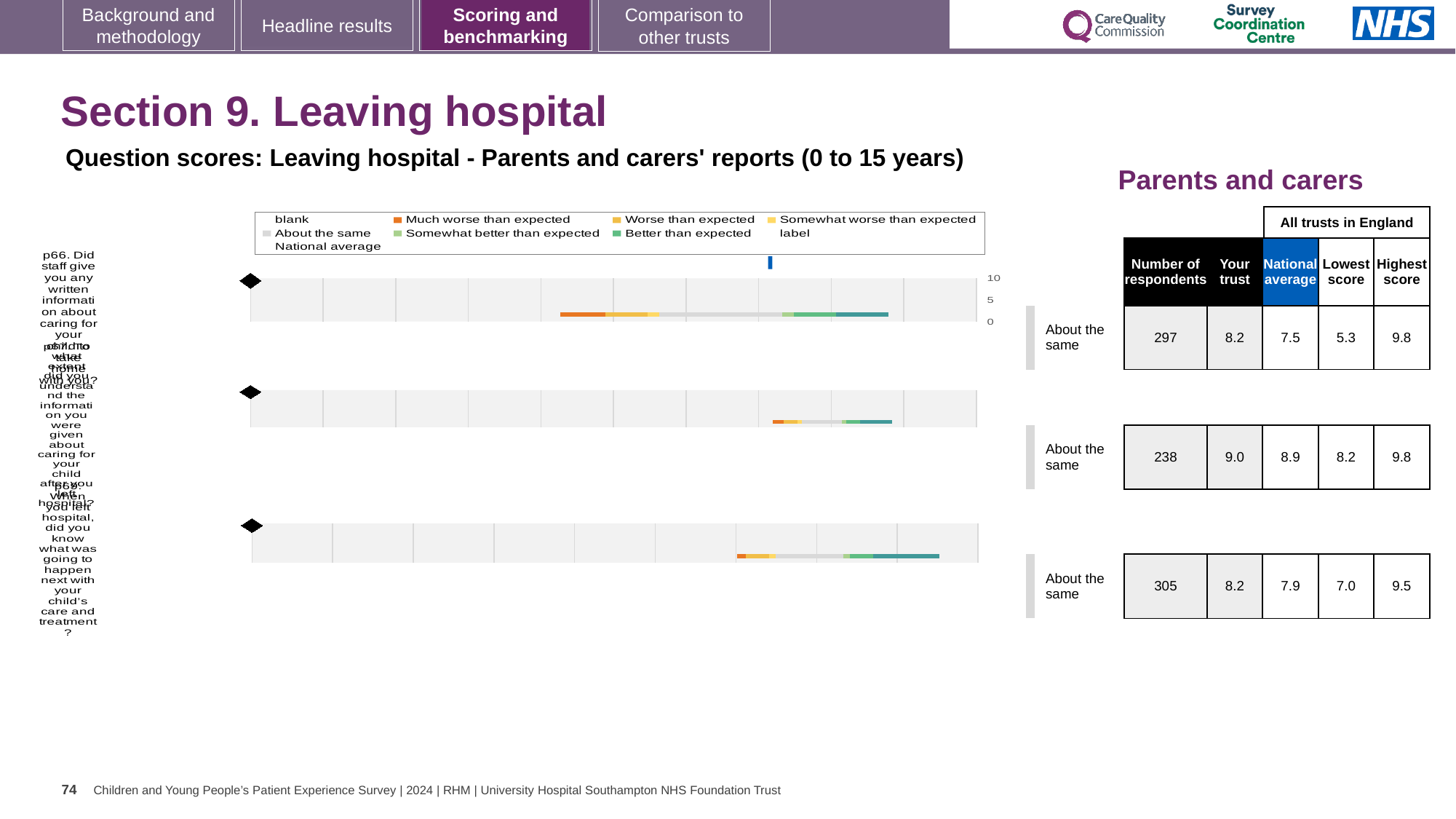
For the top row (p66), what is the difference between the 'Your trust' score and the national average? 0.7 In the table beside the charts, what is the 'Your trust' score for the middle row (p67)? 9.0 In the table beside the charts, what is the number of respondents for the top row (p66)? 297 What is the highest score among all trusts in England for the top row (p66)? 9.8 What colour does the legend use for 'Much worse than expected'? Orange For the bottom row (p68), which is larger: the 'Your trust' score or the national average? Your trust (8.2) What benchmark category label is shown next to each of the three charts? About the same Which row has the highest 'Your trust' score in the table beside the charts? The middle row (p67), 9.0 In the table beside the charts, what is the national average for the bottom row (p68)? 7.9 How many question charts (rows) are shown on the slide? 3 What is the lowest score among all trusts in England for the bottom row (p68)? 7.0 What kind of chart is used to show the question scores on this slide? Bar chart